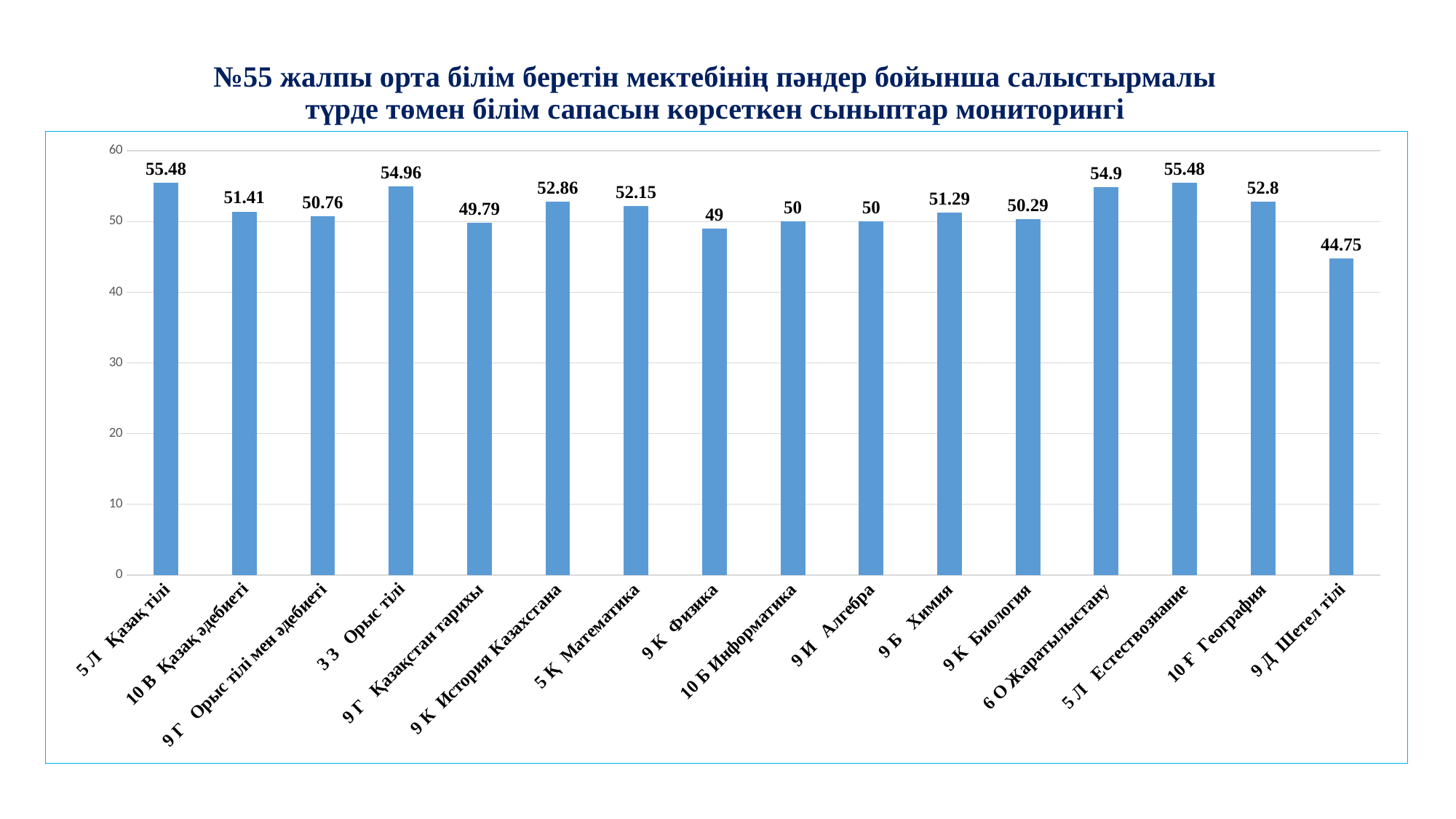
What is the value for 6 О Жаратылыстану? 54.9 Which category has the lowest value in the chart? 9 Д Шетел тілі Which is larger, the value for 10 В Қазақ әдебиеті or the value for 10 Г География? 10 Ғ География What is the value for 9 К Физика? 49 How many categories (classes/subjects) are plotted in the chart? 16 What is the value for 9 Д Шетел тілі? 44.75 What is the difference between the values for 9 К История Казахстана and 9 Г Қазақстан тарихы? 3.07 What is the value for 9 К Биология? 50.29 Is the value for 9 Д Шетел тілі greater or less than 50? less What is the value for 3 З Орыс тілі? 54.96 What is the difference between the values for 5 Л Қазақ тілі and 9 Д Шетел тілі? 10.73 What kind of chart is shown on the slide? bar chart